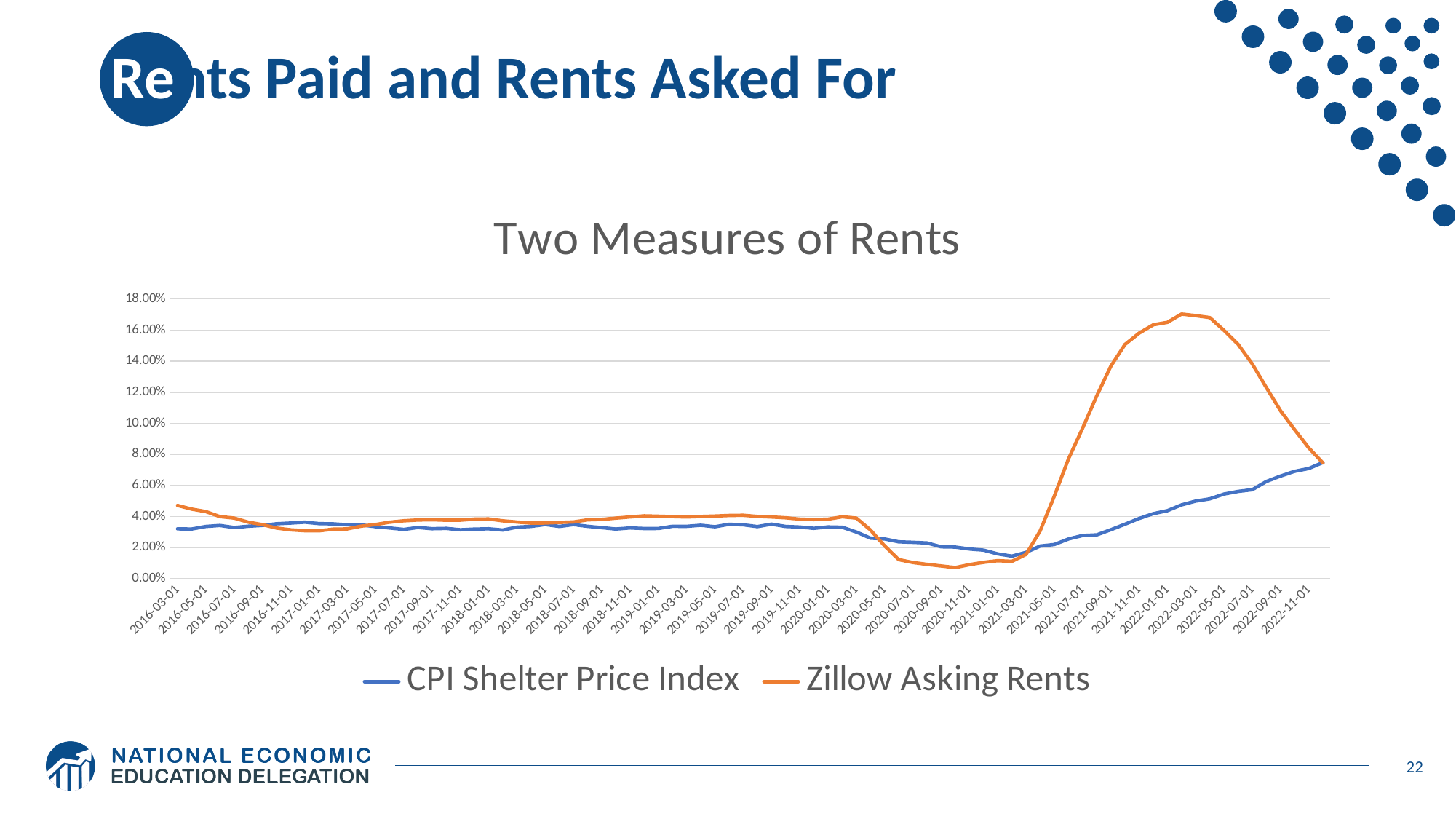
At 2022-03-01, which series has the higher value, CPI Shelter Price Index or Zillow Asking Rents? Zillow Asking Rents Which series reaches the highest value on the chart? Zillow Asking Rents Does the Zillow Asking Rents line rise or fall between 2022-03-01 and 2022-11-01? fall Which series is drawn in orange? Zillow Asking Rents What kind of chart is shown on the slide? line chart Is the value for Zillow Asking Rents at 2020-11-01 greater or less than 2.00%? less At 2020-09-01, which series has the higher value, CPI Shelter Price Index or Zillow Asking Rents? CPI Shelter Price Index What is the title of the chart? Two Measures of Rents How many series does the legend list? 2 Is the value for Zillow Asking Rents at 2022-03-01 greater or less than 16.00%? greater Is the value for CPI Shelter Price Index at 2022-11-01 greater or less than 6.00%? greater